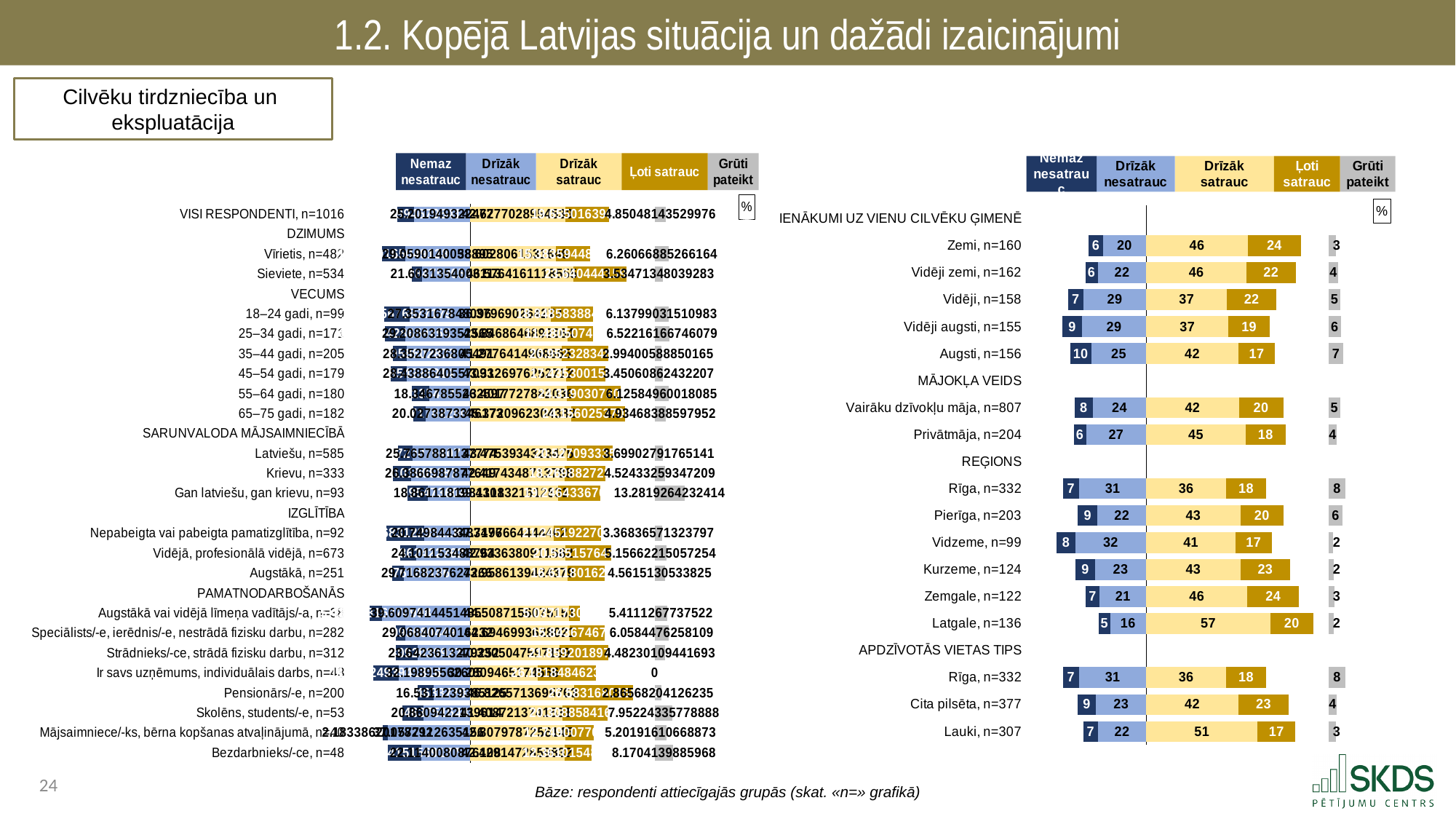
In the chart on the right, which region has the lowest "Drīzāk nesatrauc" value? Latgale, n=136 How many series does the legend of the chart on the right list? 5 In the chart on the right, which has a larger "Ļoti satrauc" value: Kurzeme (n=124) or Vidzeme (n=99)? Kurzeme, n=124 What kind of chart is the chart on the right? Stacked horizontal bar chart In the chart on the right, what is the "Nemaz nesatrauc" value for Augsti (n=156)? 10 In the chart on the right, what is the difference between the "Drīzāk satrauc" values for Lauki (n=307) and Rīga (n=332)? 15 In the chart on the right, what is the "Grūti pateikt" value for Rīga (n=332)? 8 In the chart on the right, what is the total of the stacked bar for Vidzeme (n=99)? 100 In the chart on the right, which region has the highest "Drīzāk satrauc" value? Latgale, n=136 In the chart on the right, what percentage of respondents in the Latgale region (n=136) answered "Drīzāk satrauc"? 57 In the chart on the right, what is the "Ļoti satrauc" value for the Zemi income group (n=160)? 24 In the chart on the right, how many bars are shown under the heading REĢIONS? 6